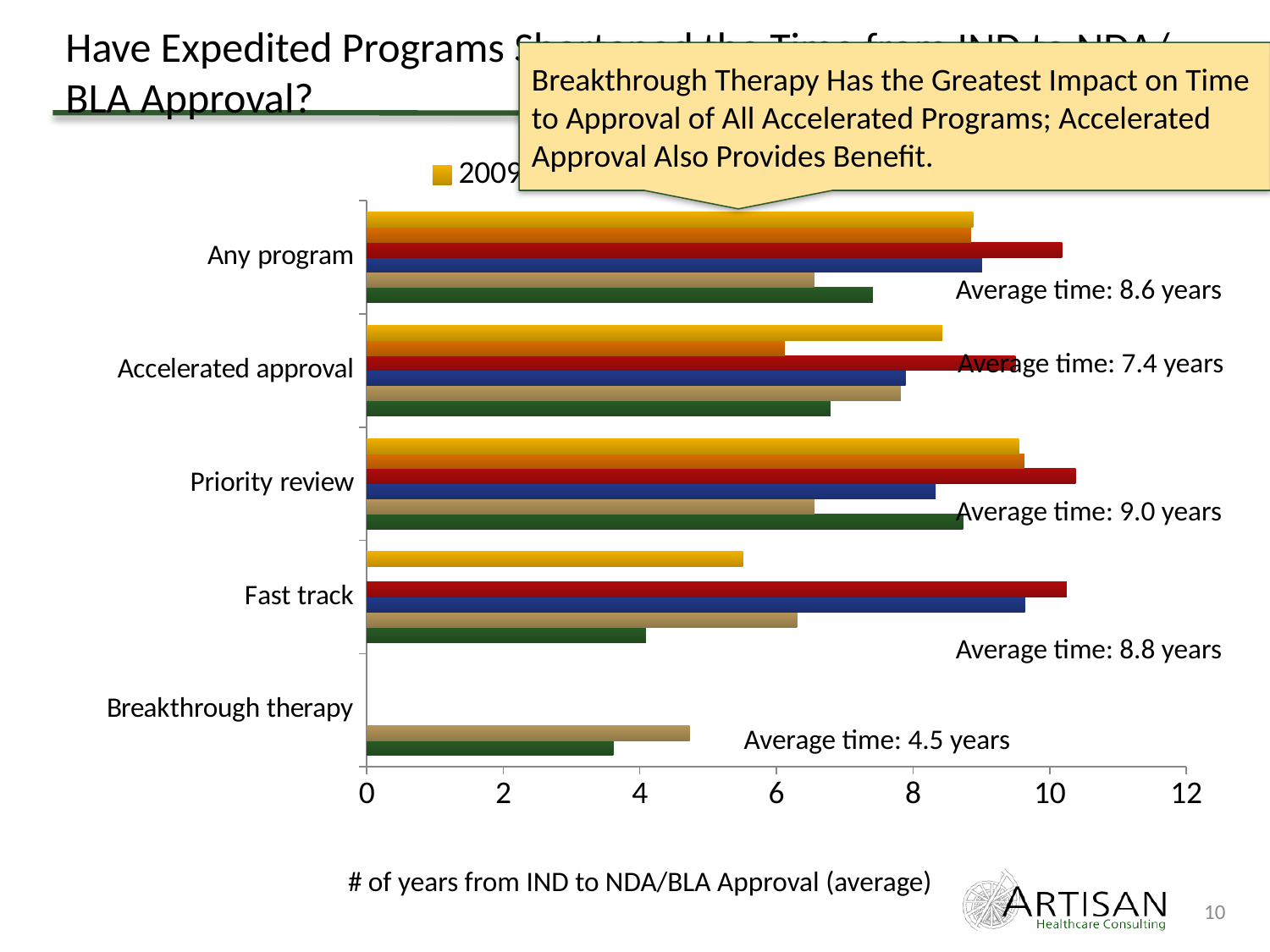
What is the difference between the average time for Priority review and the average time for Breakthrough therapy? 4.5 years How many expedited program categories are listed on the vertical axis of the chart? 5 What is the title of the horizontal axis of the chart? # of years from IND to NDA/BLA Approval (average) Which program category has the highest average time to approval? Priority review What is the average time shown for Accelerated approval? 7.4 years Is the value of the green bar for Breakthrough therapy greater or less than 4? less Is the value of the dark red bar for Priority review greater or less than 10? greater What is the average time from IND to NDA/BLA approval shown for Any program? 8.6 years What kind of chart is shown on the slide? bar chart Which program category has the lowest average time to approval? Breakthrough therapy Which has a larger average time to approval, Any program or Fast track? Fast track What is the average time shown for Breakthrough therapy? 4.5 years